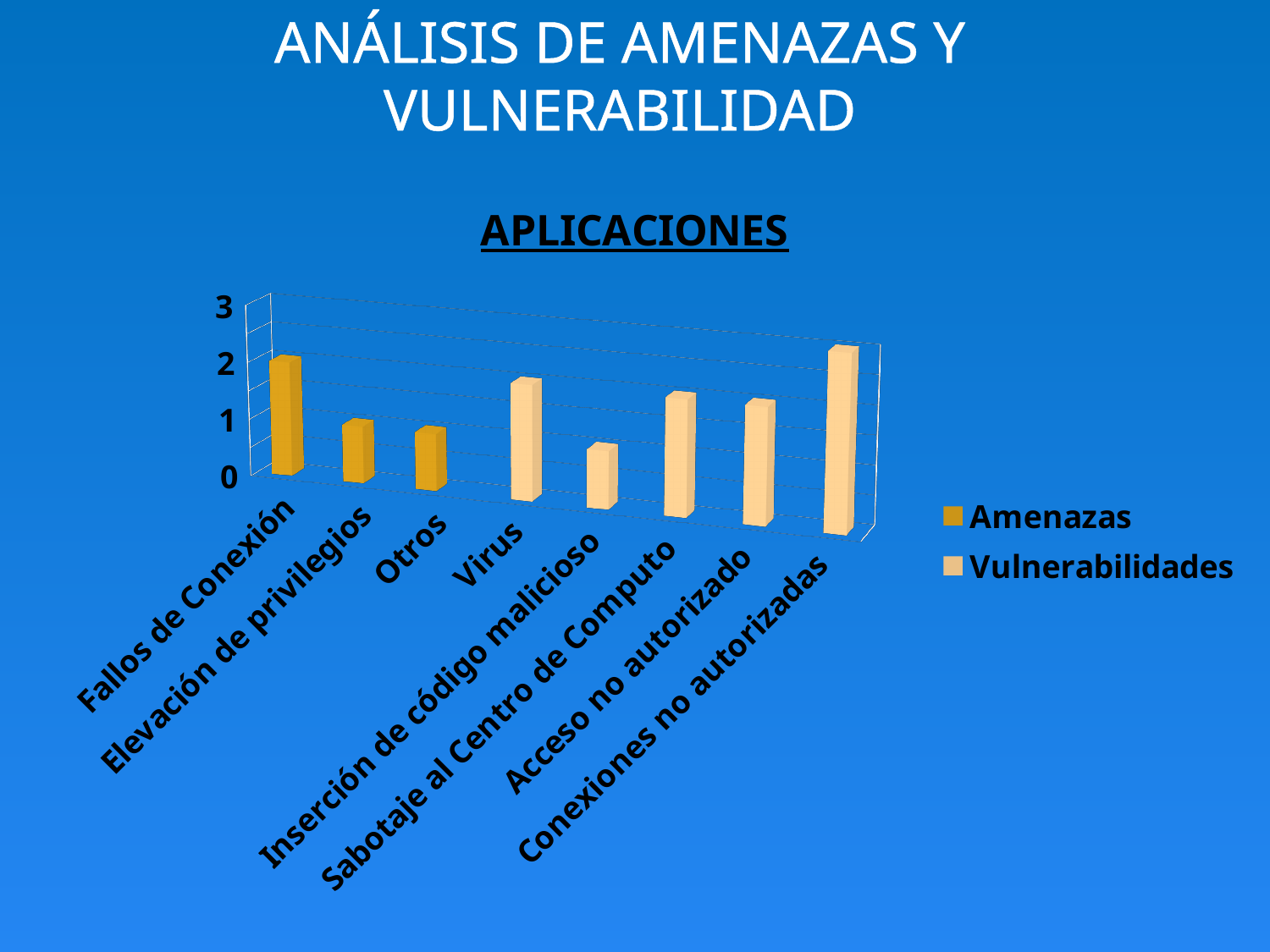
Which is larger, the value for Fallos de Conexión or the value for Elevación de privilegios? Fallos de Conexión Is the value for Inserción de código malicioso greater or less than 2? less Which is larger, the value for Conexiones no autorizadas or the value for Acceso no autorizado? Conexiones no autorizadas What kind of chart is shown on the slide? Bar chart How many categories are shown on the x axis of the chart? 8 Is the value for Elevación de privilegios greater or less than 2? less Is the value for Conexiones no autorizadas greater or less than 1? greater What are the two series named in the chart's legend? Amenazas and Vulnerabilidades Which category has the highest bar in the chart? Conexiones no autorizadas What is the title of the chart? APLICACIONES How many series does the chart's legend list? 2